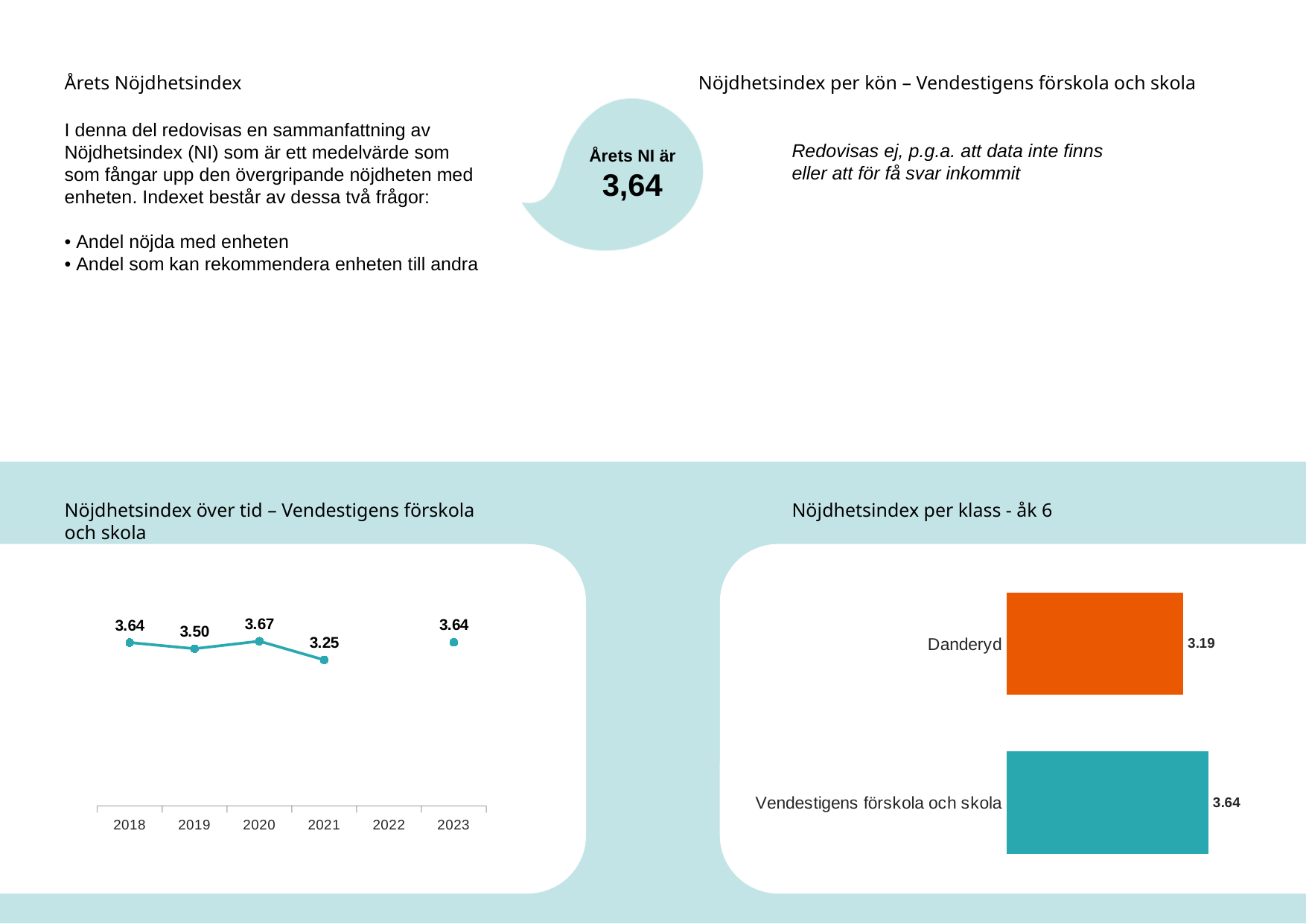
In the 'Nöjdhetsindex över tid' chart, what is the value for 2021? 3.25 In the 'Nöjdhetsindex per klass - åk 6' chart, what is the difference between Vendestigens förskola och skola and Danderyd? 0.45 In the 'Nöjdhetsindex över tid' chart, what is the difference between the 2020 value and the 2021 value? 0.42 In the 'Nöjdhetsindex per klass - åk 6' chart, what is the value for Danderyd? 3.19 In the 'Nöjdhetsindex över tid' chart, which year has the highest value? 2020 In the 'Nöjdhetsindex över tid' chart, what is the value for 2018? 3.64 In the 'Nöjdhetsindex över tid' chart, which year has the lowest value? 2021 What kind of chart is 'Nöjdhetsindex över tid – Vendestigens förskola och skola'? Line chart In the 'Nöjdhetsindex över tid' chart, which year has the larger value, 2019 or 2023? 2023 What kind of chart is 'Nöjdhetsindex per klass - åk 6'? Bar chart In the 'Nöjdhetsindex per klass - åk 6' chart, what is the value for Vendestigens förskola och skola? 3.64 In the 'Nöjdhetsindex över tid' chart, how many years are shown on the x axis? 6